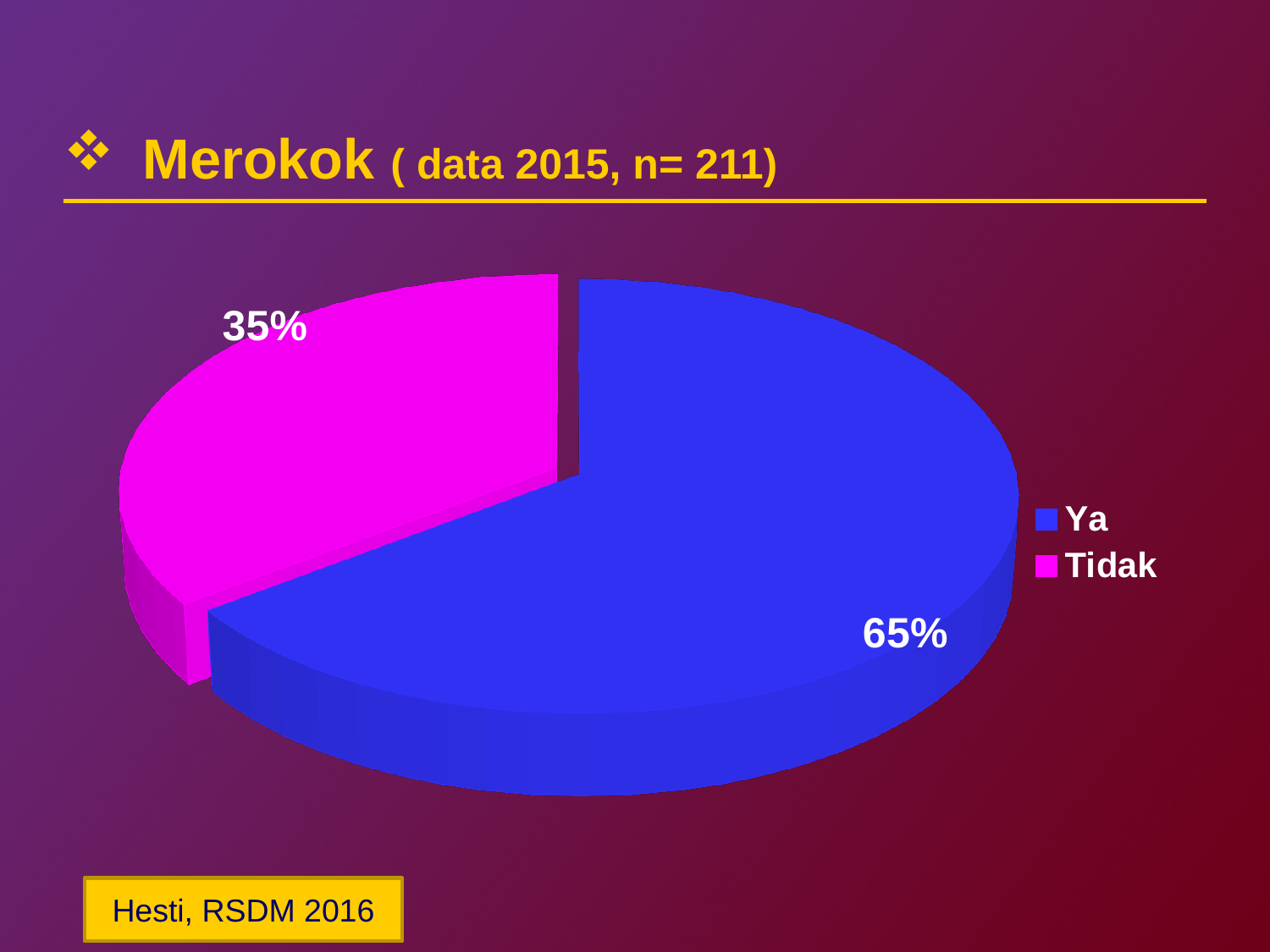
What share of the pie does the "Tidak" slice represent? 35% What is the sample size (n) stated in the slide title? 211 What percentage of the pie is labelled "Ya"? 65% What colour is the "Ya" slice? blue What kind of chart is shown on the slide? pie chart Which slice is the largest? Ya Which slice is the smallest? Tidak What percentage of the pie is labelled "Tidak"? 35% Which slice is larger, "Ya" or "Tidak"? Ya What is the difference in percentage points between the "Ya" and "Tidak" slices? 30 How many slices does the pie chart have? 2 How many entries does the legend list? 2